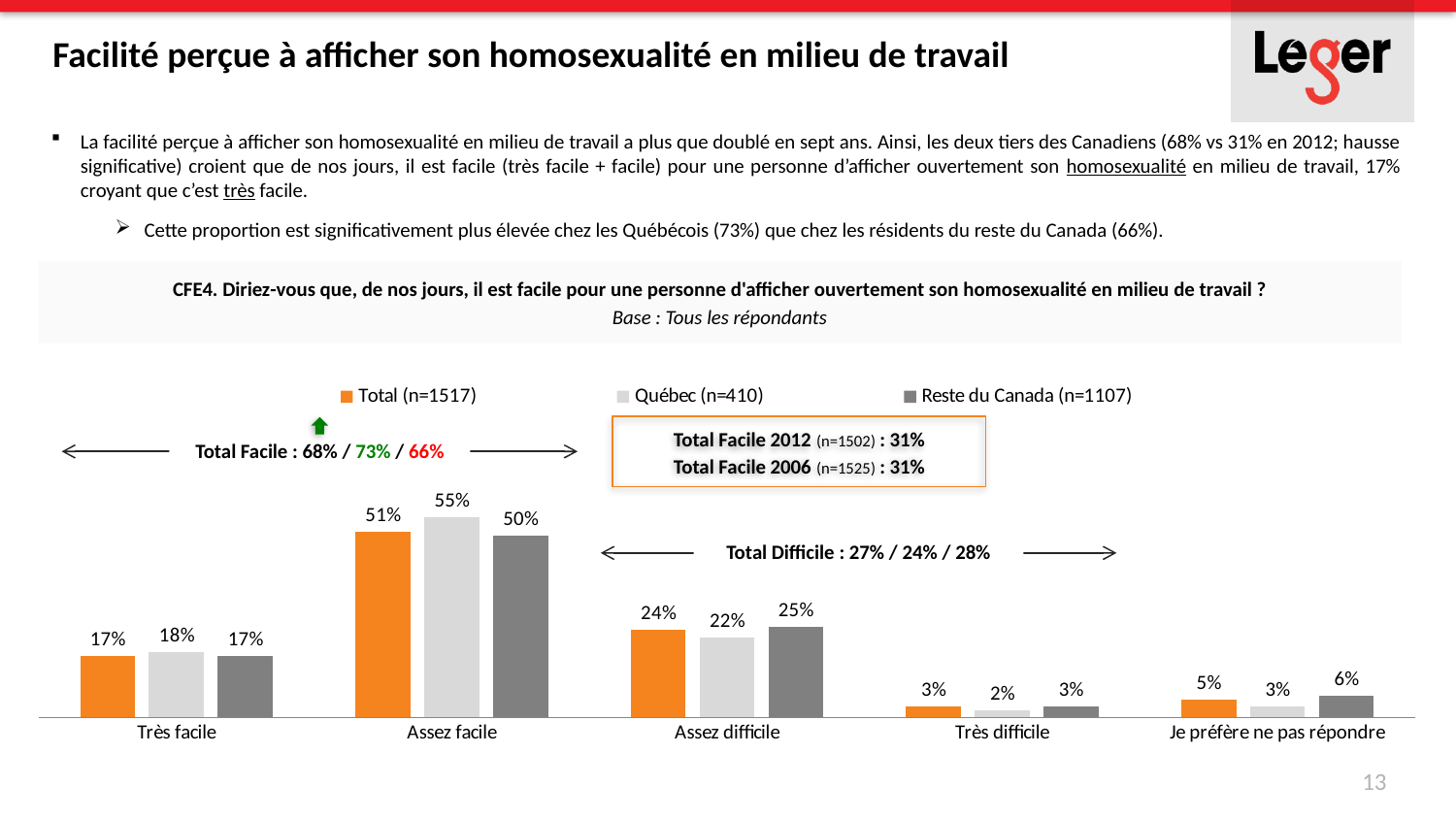
Which category has the highest value for the Total (n=1517) series? Assez facile What is the value for Total (n=1517) in the Assez facile category? 51% How many series does the legend list? 3 What is the difference between the Québec and Reste du Canada values in the Assez facile category? 5% What is the value for Québec (n=410) in the Très difficile category? 2% What is the value for Reste du Canada (n=1107) in the Assez difficile category? 25% What kind of chart is shown on the slide? Bar chart Which category has the lowest value for the Reste du Canada (n=1107) series? Très difficile Which is larger in the Assez difficile category: the Total value or the Québec value? Total How many categories are shown on the x axis of the chart? 5 What is the value for Québec (n=410) in the Assez facile category? 55% What is the Total Facile 2012 value shown in the box on the chart? 31%